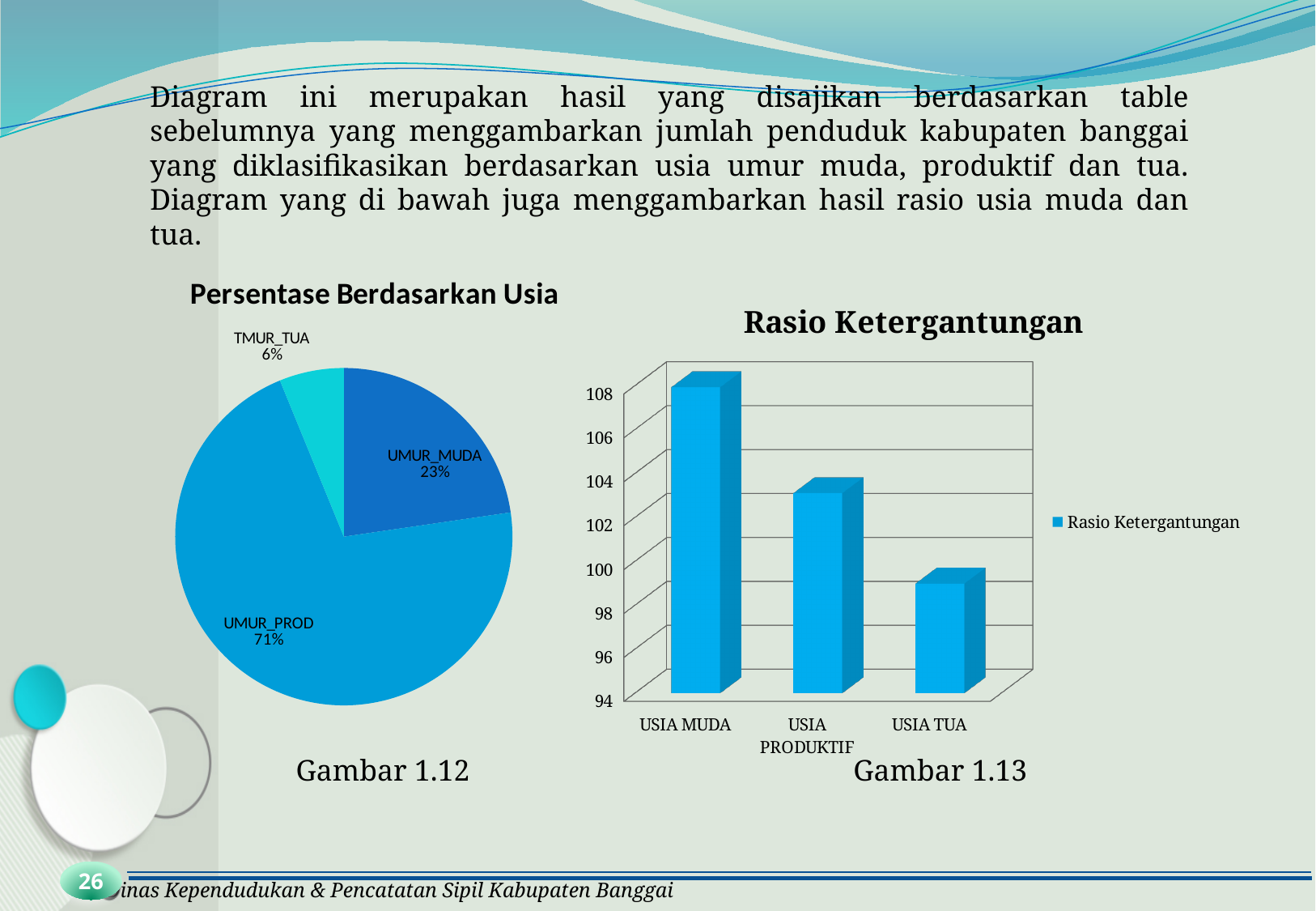
In the bar chart 'Rasio Ketergantungan', do the values rise or fall from USIA MUDA to USIA TUA? fall What kind of chart is 'Rasio Ketergantungan'? Bar chart In the pie chart 'Persentase Berdasarkan Usia', what percentage is shown for UMUR_PROD? 71% In the pie chart 'Persentase Berdasarkan Usia', which slice is the smallest? TMUR_TUA In the pie chart 'Persentase Berdasarkan Usia', what is the difference in percentage points between UMUR_PROD and UMUR_MUDA? 48 In the pie chart 'Persentase Berdasarkan Usia', what percentage is shown for TMUR_TUA? 6% In the bar chart 'Rasio Ketergantungan', is the value for USIA TUA greater or less than 102? less How many slices does the pie chart 'Persentase Berdasarkan Usia' have? 3 In the bar chart 'Rasio Ketergantungan', is the value for USIA MUDA greater or less than 106? greater In the pie chart 'Persentase Berdasarkan Usia', what percentage is shown for UMUR_MUDA? 23% In the pie chart 'Persentase Berdasarkan Usia', which slice is the largest? UMUR_PROD In the bar chart 'Rasio Ketergantungan', which category has the highest value? USIA MUDA